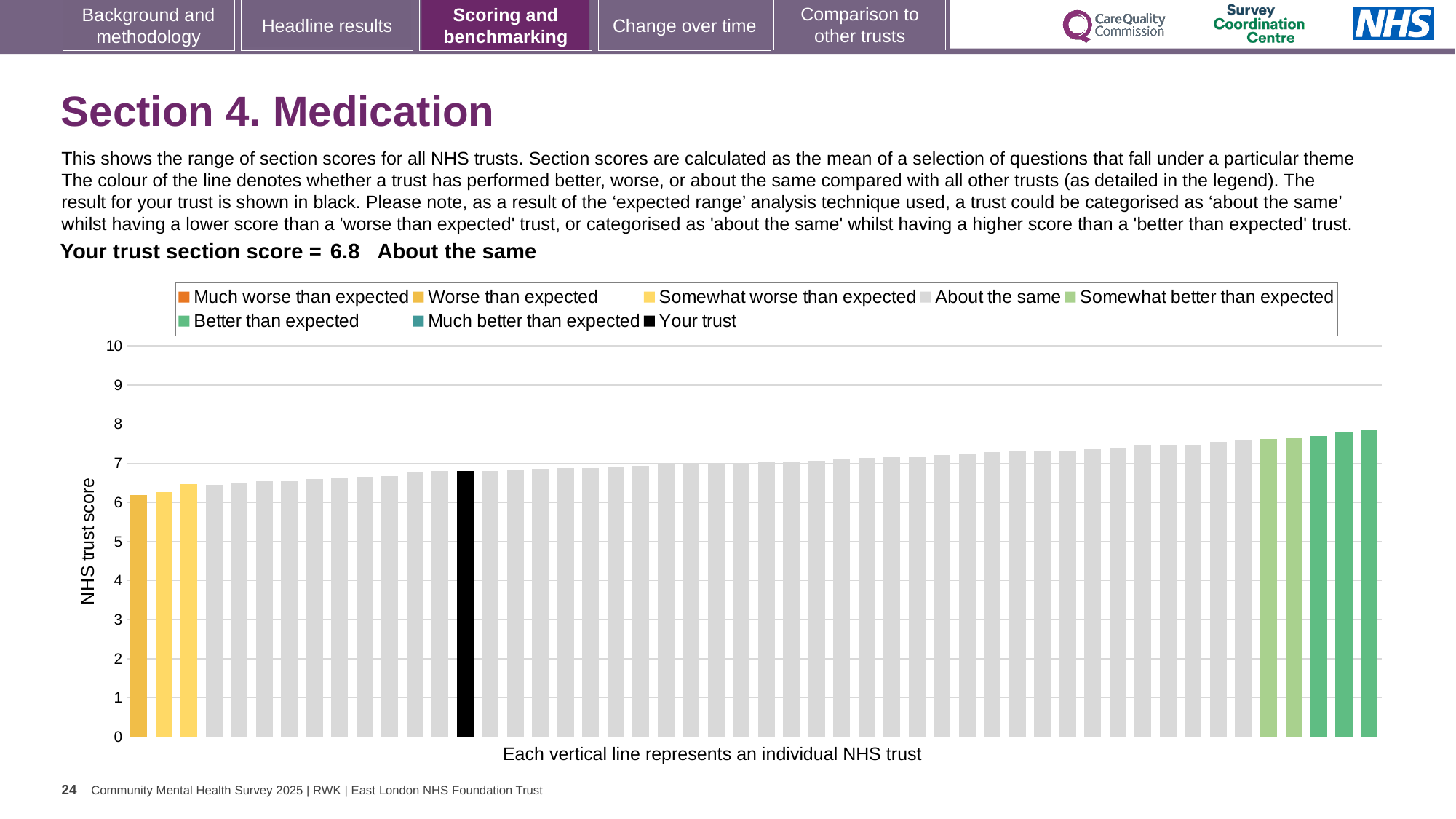
Which category is your trust placed in according to the text above the chart? About the same How many entries does the chart legend list? 8 Is the value of the shortest bar greater or less than 6? greater What colour is the bar representing your trust? black Is the value of the tallest bar greater or less than 8? less Is the value of the black bar (your trust) greater or less than 6? greater What is the label on the y axis of the chart? NHS trust score What is the section score for your trust shown on the slide? 6.8 Is the leftmost bar larger or smaller than the rightmost bar? smaller What kind of chart is shown on the slide? bar chart Do the bar values rise or fall from left to right along the x axis? rise